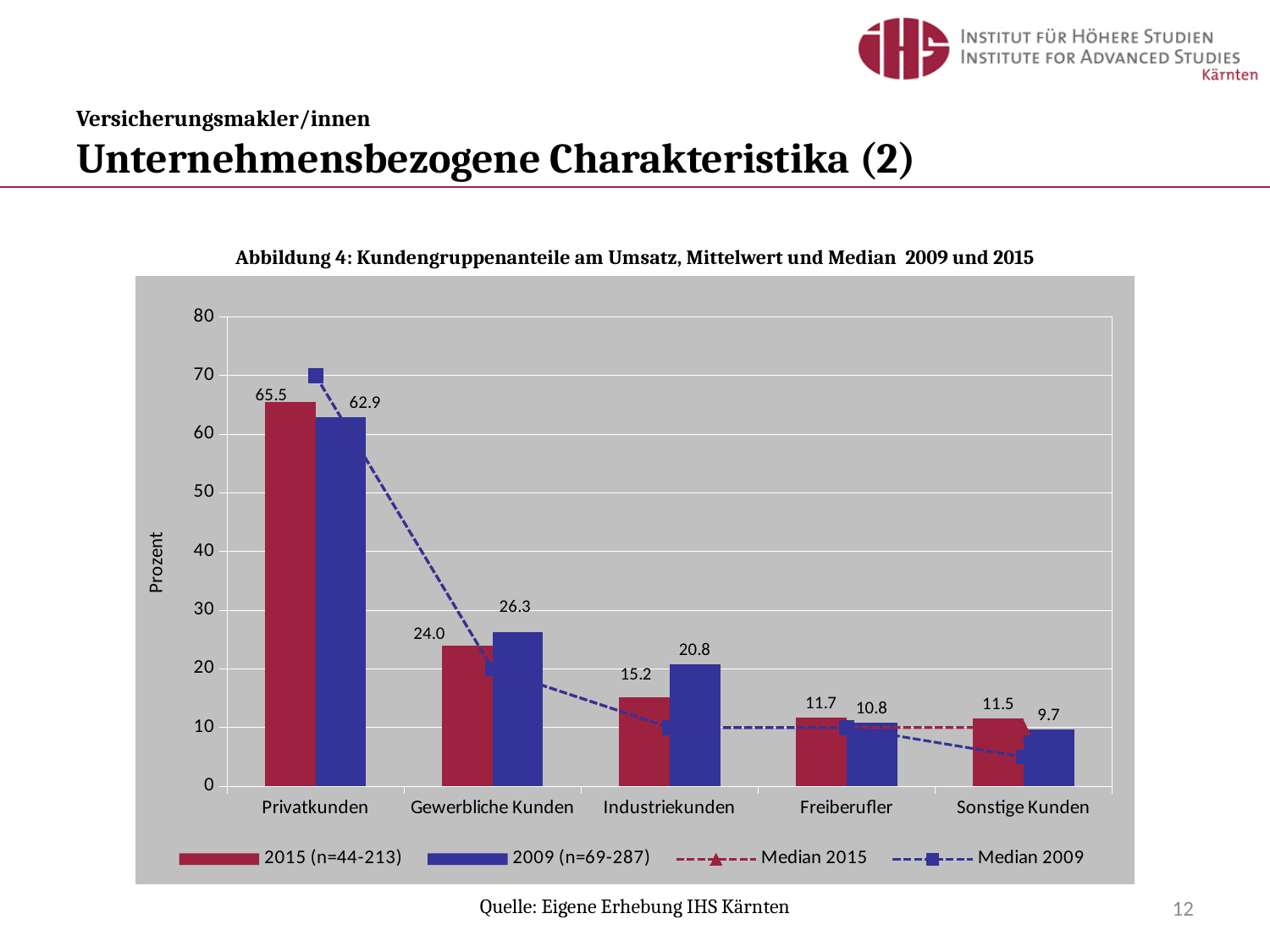
What is the value of the 2009 bar for Industriekunden? 20.8 What is the value of the 2015 bar for Privatkunden? 65.5 How many customer groups are shown on the x axis? 5 How many series does the legend list? 4 Is the Median 2009 value for Privatkunden greater or less than 60? greater Which customer group has the lowest 2009 value? Sonstige Kunden What is the difference between the 2009 and 2015 values for Industriekunden? 5.6 What is the difference between the 2015 and 2009 values for Privatkunden? 2.6 Which customer group has the highest 2009 value? Privatkunden Do the 2009 bar values rise or fall from Privatkunden to Sonstige Kunden? fall What is the value of the 2015 bar for Freiberufler? 11.7 For Gewerbliche Kunden, which is larger: the 2015 value or the 2009 value? 2009